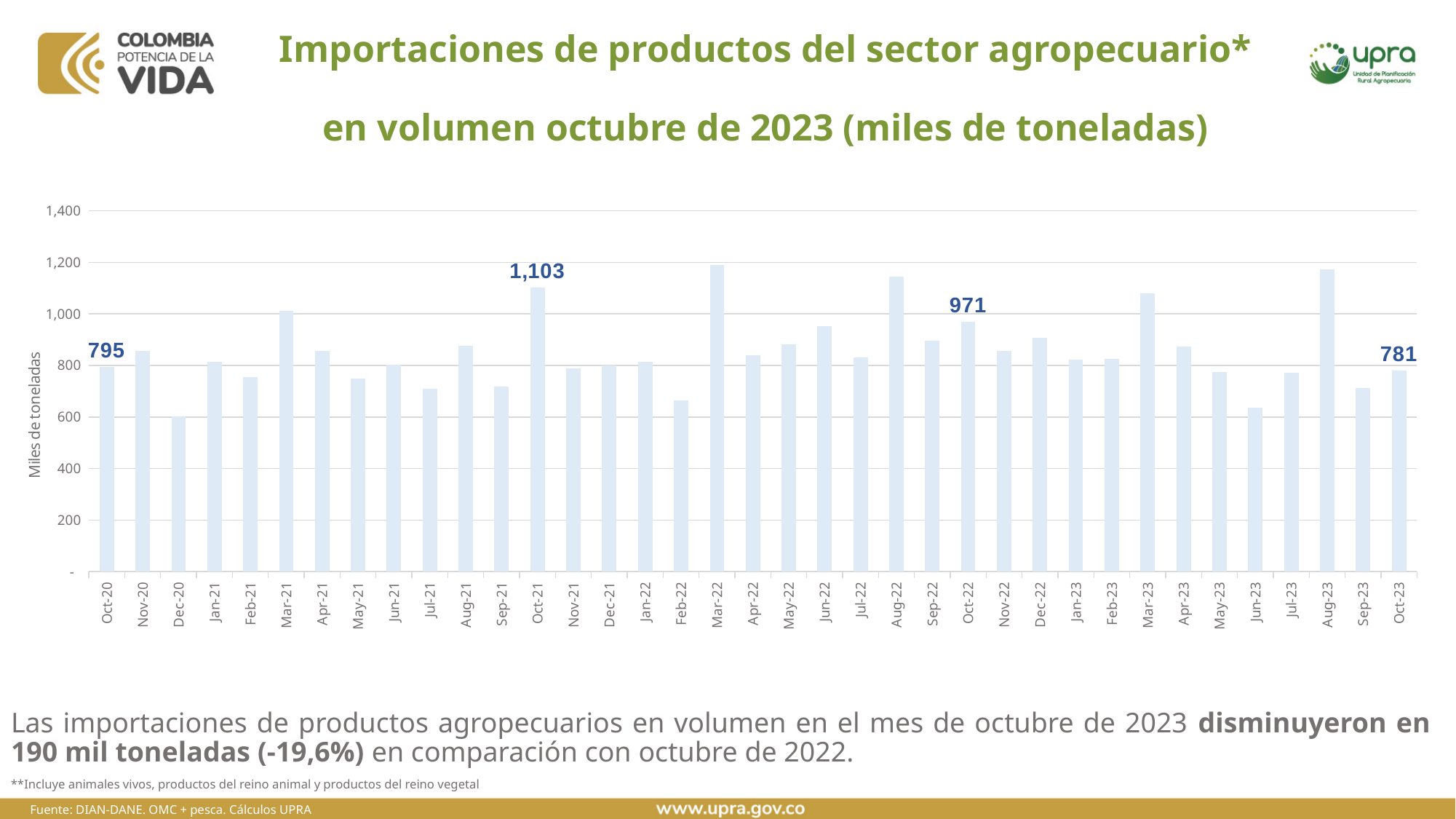
How many months are plotted in the chart? 37 Which is larger, the value for Oct-21 or the value for Oct-22? Oct-21 Is the value for Mar-22 greater or less than 1,000? greater What is the value for Oct-22? 971 What is the value for Oct-23? 781 What is the value for Oct-21? 1,103 What is the difference between the values for Oct-21 and Oct-20? 308 Which month has the lowest value in the chart? Dec-20 What is the difference between the values for Oct-22 and Oct-23? 190 What kind of chart is shown on the slide? Bar chart What is the value for Oct-20? 795 Is the value for Dec-20 greater or less than 800? less